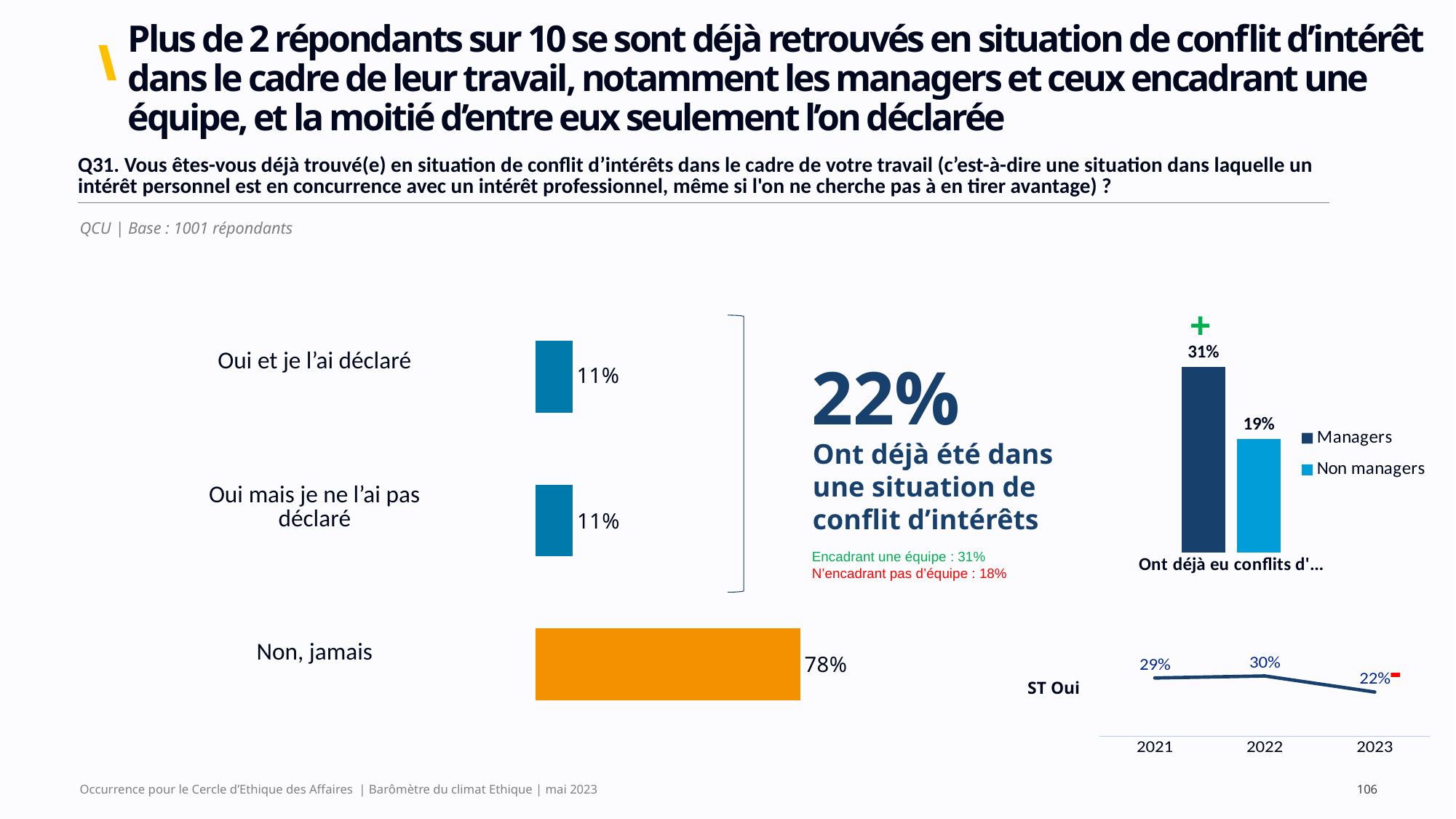
In the horizontal bar chart on the left, what is the difference between "Non, jamais" and "Oui mais je ne l'ai pas déclaré"? 67% In the vertical bar chart on the right, which is larger, Managers or Non managers? Managers In the vertical bar chart on the right, how many series does the legend list? 2 In the horizontal bar chart on the left, what colour is the bar for "Non, jamais"? Orange In the horizontal bar chart on the left, which category has the highest value? Non, jamais In the horizontal bar chart on the left, what is the value for "Non, jamais"? 78% In the horizontal bar chart on the left, how many categories are shown? 3 In the line chart at the bottom right (ST Oui), what is the value for 2023? 22% In the line chart at the bottom right (ST Oui), what is the difference between 2022 and 2023? 8% In the vertical bar chart on the right, what is the value for Managers? 31% In the vertical bar chart on the right, what is the value for Non managers? 19% In the horizontal bar chart on the left, what is the value for "Oui et je l'ai déclaré"? 11%